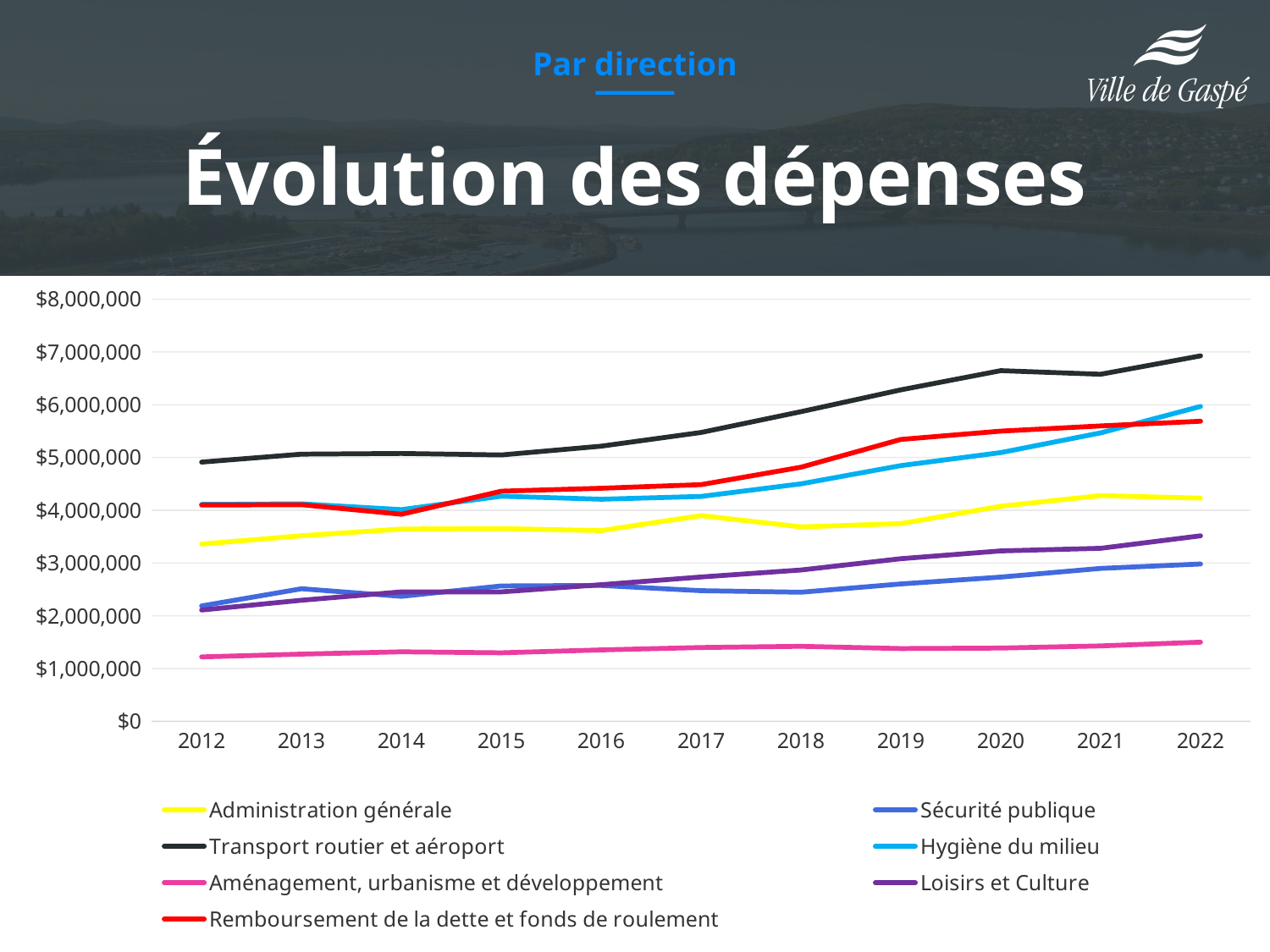
Does the value for Hygiène du milieu rise or fall from 2012 to 2022? rise How many years are shown along the x axis? 11 What kind of chart is shown on the slide? line chart In 2022, which is larger: Administration générale or Loisirs et Culture? Administration générale Is the value for Loisirs et Culture in 2022 greater or less than $3,000,000? greater In which year does Transport routier et aéroport reach its highest value? 2022 Which series has the lowest value in 2022? Aménagement, urbanisme et développement What is the title of the chart? Évolution des dépenses Which series has the highest value in 2022? Transport routier et aéroport Is the value for Transport routier et aéroport in 2022 greater or less than $6,000,000? greater Is the value for Aménagement, urbanisme et développement in 2012 greater or less than $2,000,000? less How many series does the legend list? 7